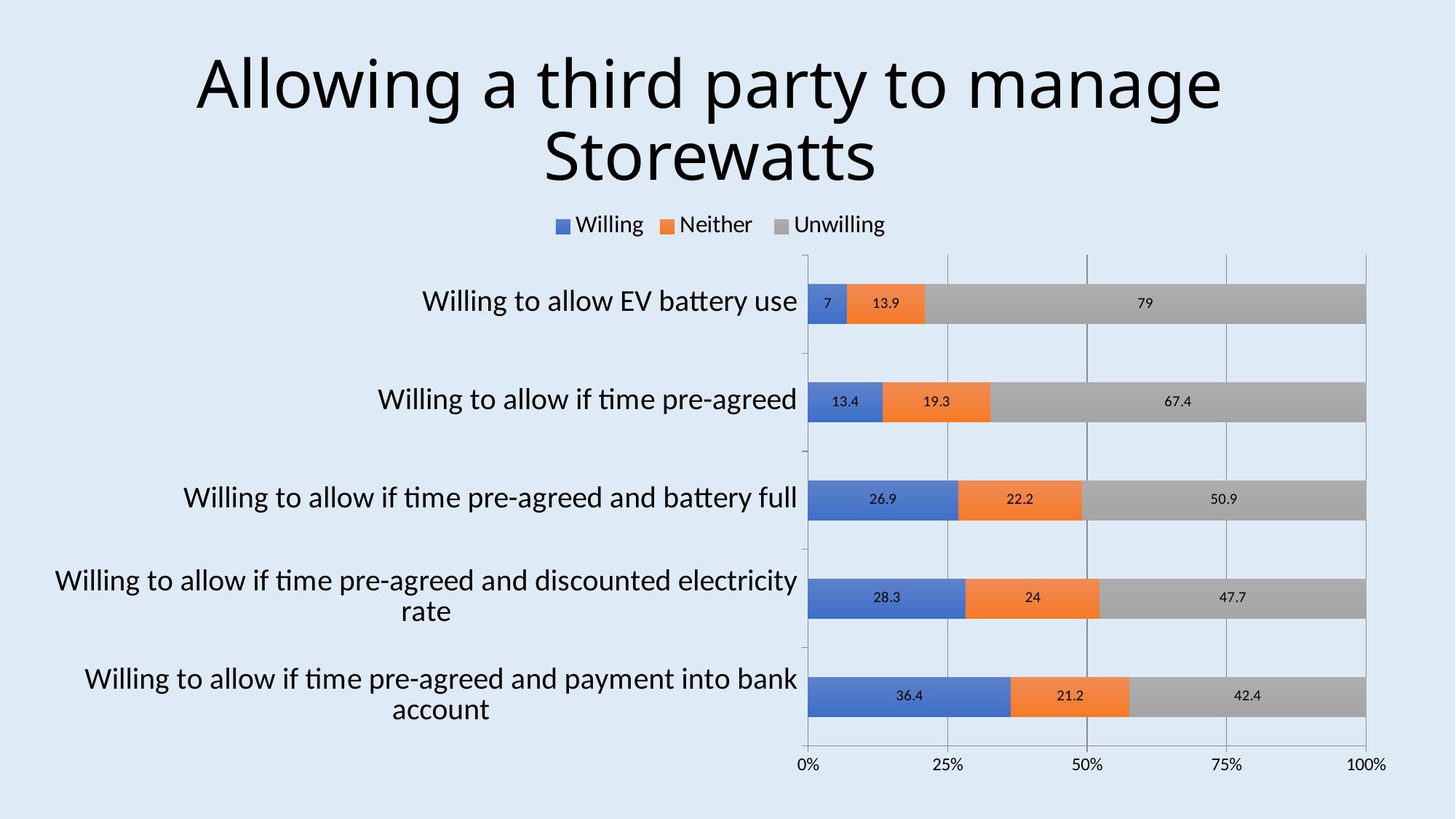
What is the Willing value for 'Willing to allow if time pre-agreed and payment into bank account'? 36.4 Which category has the highest Willing value? Willing to allow if time pre-agreed and payment into bank account What is the Neither value for 'Willing to allow if time pre-agreed and discounted electricity rate'? 24 Which is larger: the Willing value for 'Willing to allow if time pre-agreed and battery full' or the Willing value for 'Willing to allow if time pre-agreed'? Willing to allow if time pre-agreed and battery full Which category has the lowest Unwilling value? Willing to allow if time pre-agreed and payment into bank account How many series does the legend list? 3 What kind of chart is shown on the slide? Stacked bar chart What is the Unwilling value for 'Willing to allow EV battery use'? 79 What is the difference between the Unwilling value for 'Willing to allow EV battery use' and the Unwilling value for 'Willing to allow if time pre-agreed and payment into bank account'? 36.6 What is the title of the chart? Allowing a third party to manage Storewatts What is the total of the stacked bar for 'Willing to allow if time pre-agreed and battery full'? 100 How many categories are shown on the chart? 5